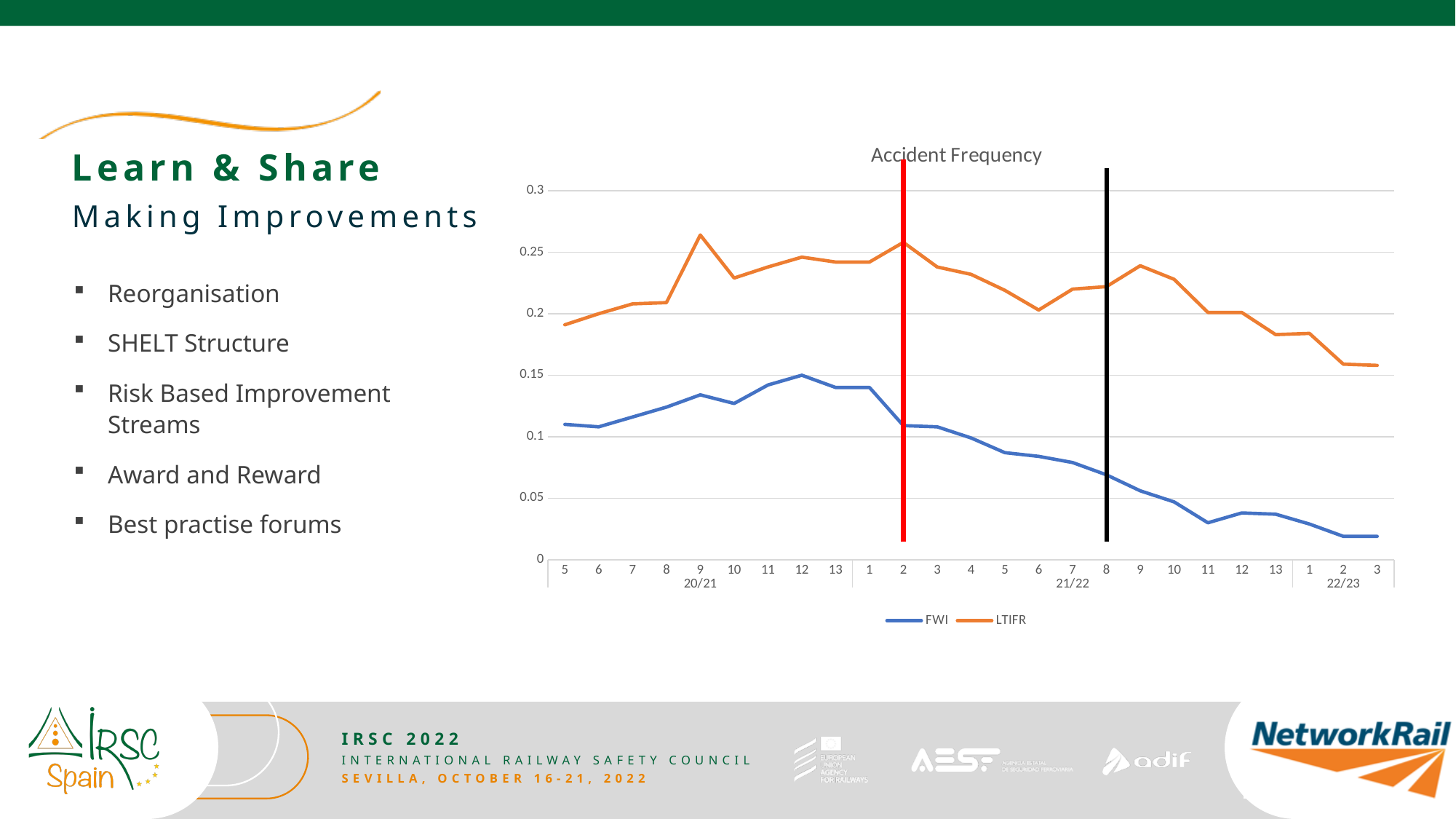
Is the LTIFR value for period 5 of 20/21 greater or less than 0.2? less How many periods are plotted along the x axis of the chart? 25 How many series does the chart legend list? 2 What is the title of the chart? Accident Frequency In which period does the FWI series reach its highest value? Period 12 of 20/21 Is the FWI value for period 2 of 22/23 greater or less than 0.05? less Is the LTIFR value for period 9 of 20/21 greater or less than 0.25? greater Which series has the higher value at period 1 of 22/23, FWI or LTIFR? LTIFR Which series is drawn in orange? LTIFR In which period does the LTIFR series reach its highest value? Period 9 of 20/21 Does the FWI series generally rise or fall from period 1 of 21/22 to period 3 of 22/23? Fall What type of chart is shown on the slide? Line chart